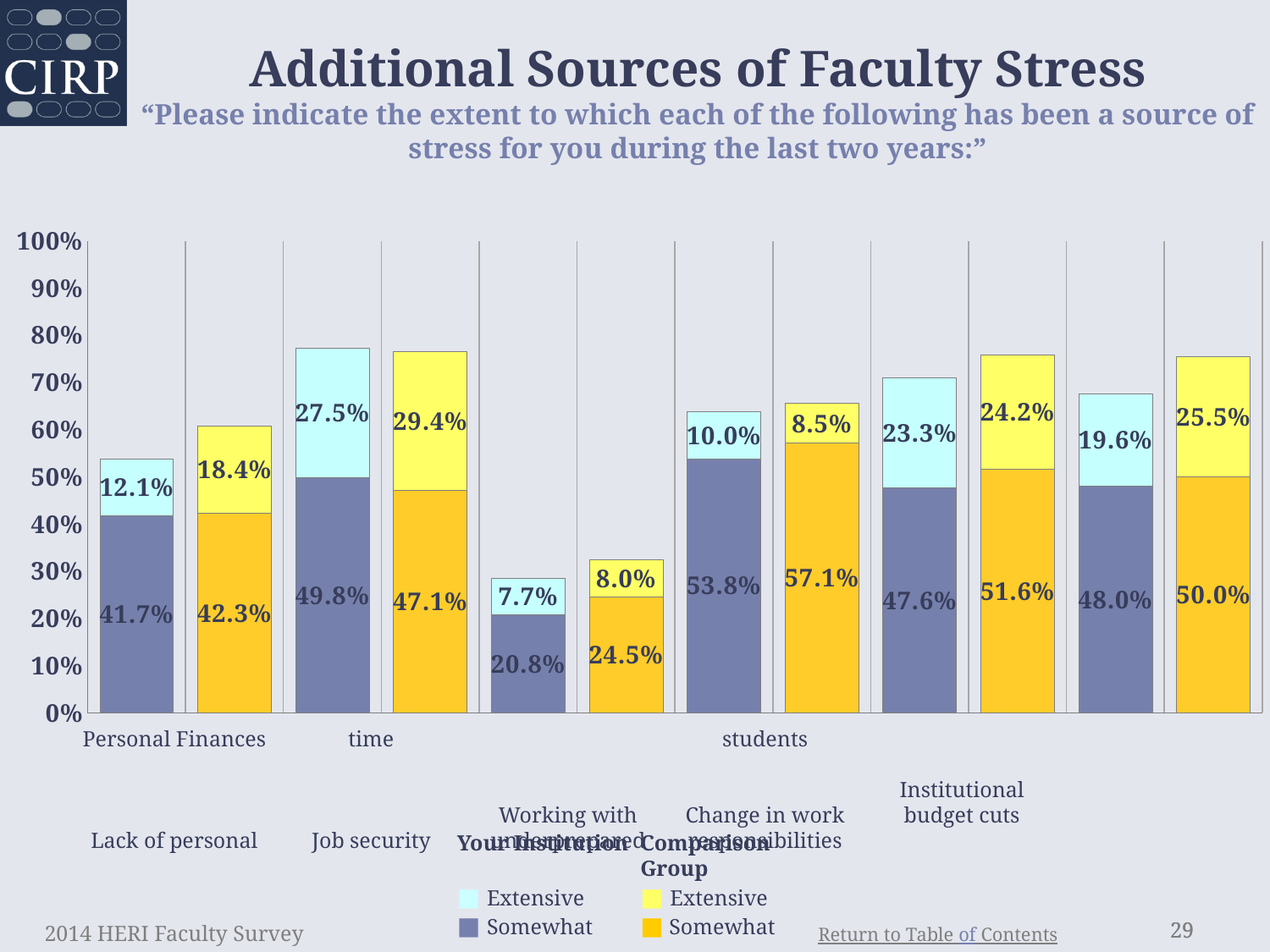
How many series does the legend list? 4 What is the Comparison Group 'Extensive' value for Institutional budget cuts? 25.5% Which is larger: the Your Institution 'Somewhat' value for Job security or the Comparison Group 'Somewhat' value for Job security? Comparison Group (24.5%) What is the total height of the Your Institution stacked bar for Institutional budget cuts? 67.6% What is the Comparison Group 'Somewhat' value for Personal Finances? 42.3% Which category has the lowest Your Institution 'Somewhat' value? Job security What is the difference between the Comparison Group and Your Institution 'Extensive' values for Personal Finances? 6.3% What is the Your Institution 'Extensive' value for Job security? 7.7% What is the total height of the Comparison Group stacked bar for Personal Finances? 60.7% What percentage of faculty at Your Institution reported Personal Finances as a 'Somewhat' source of stress? 41.7% What type of chart is shown on the slide? Stacked bar chart What is the title of the chart on the slide? Additional Sources of Faculty Stress